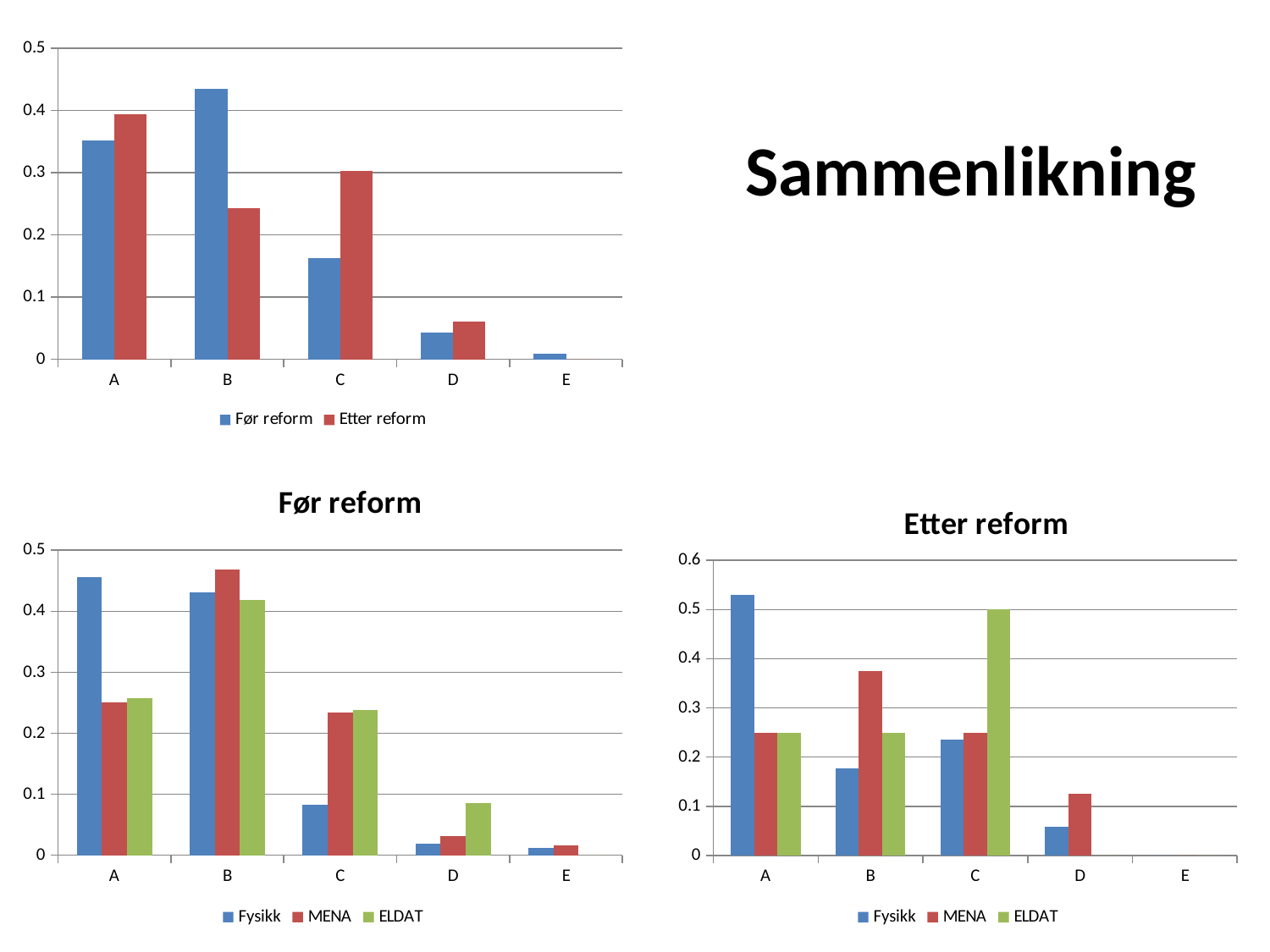
In the top-left chart, is the Før reform value for B greater or less than 0.4? greater In the 'Etter reform' chart, which series has the highest value for category B? MENA In the top-left chart, which category has the highest value for Før reform? B In the 'Før reform' chart, which series has the highest value for category B? MENA In the top-left chart, is the Etter reform value for C greater or less than 0.2? greater What kind of chart is the 'Etter reform' chart? bar chart In the top-left chart, which is larger for category B: Før reform or Etter reform? Før reform In the top-left chart, how many series does the legend list? 2 In the 'Før reform' chart, is the Fysikk value for A greater or less than 0.4? greater How many categories are shown on the x axis of the 'Etter reform' chart? 5